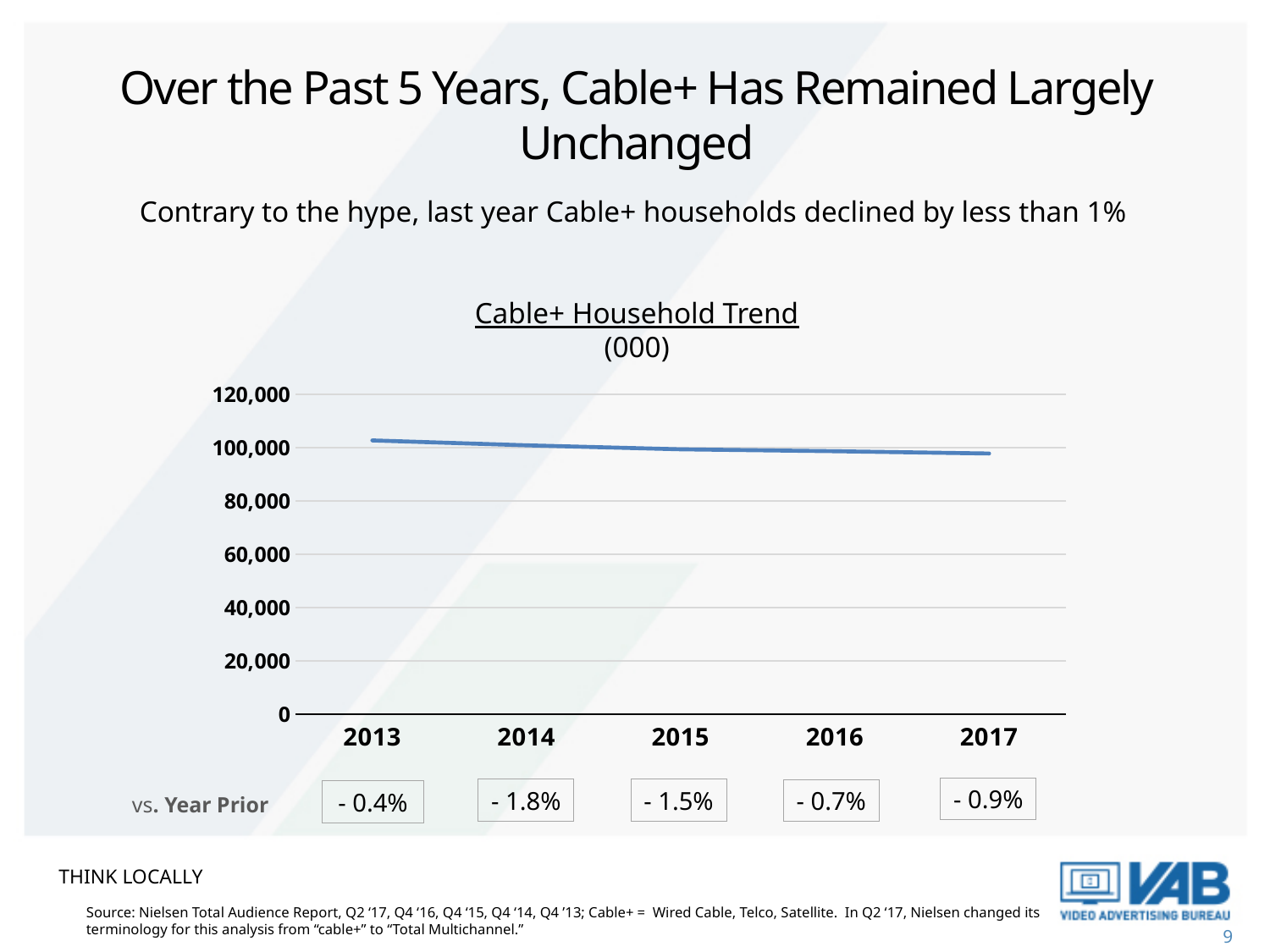
Which year has the lowest value in the chart? 2017 Which year has the highest value in the chart? 2013 Is the value for 2017 greater or less than 120,000? less Do the values in the chart rise or fall from 2013 to 2017? fall In what units are the chart values expressed, as shown under the title? (000) Is the value for 2013 greater or less than 80,000? greater What is the title of the chart? Cable+ Household Trend What is the 'vs. Year Prior' change shown for 2014? - 1.8% What kind of chart is shown on the slide? line chart Is the value for 2015 greater or less than 60,000? greater What is the 'vs. Year Prior' change shown for 2017? - 0.9% How many years are plotted on the x axis of the chart? 5